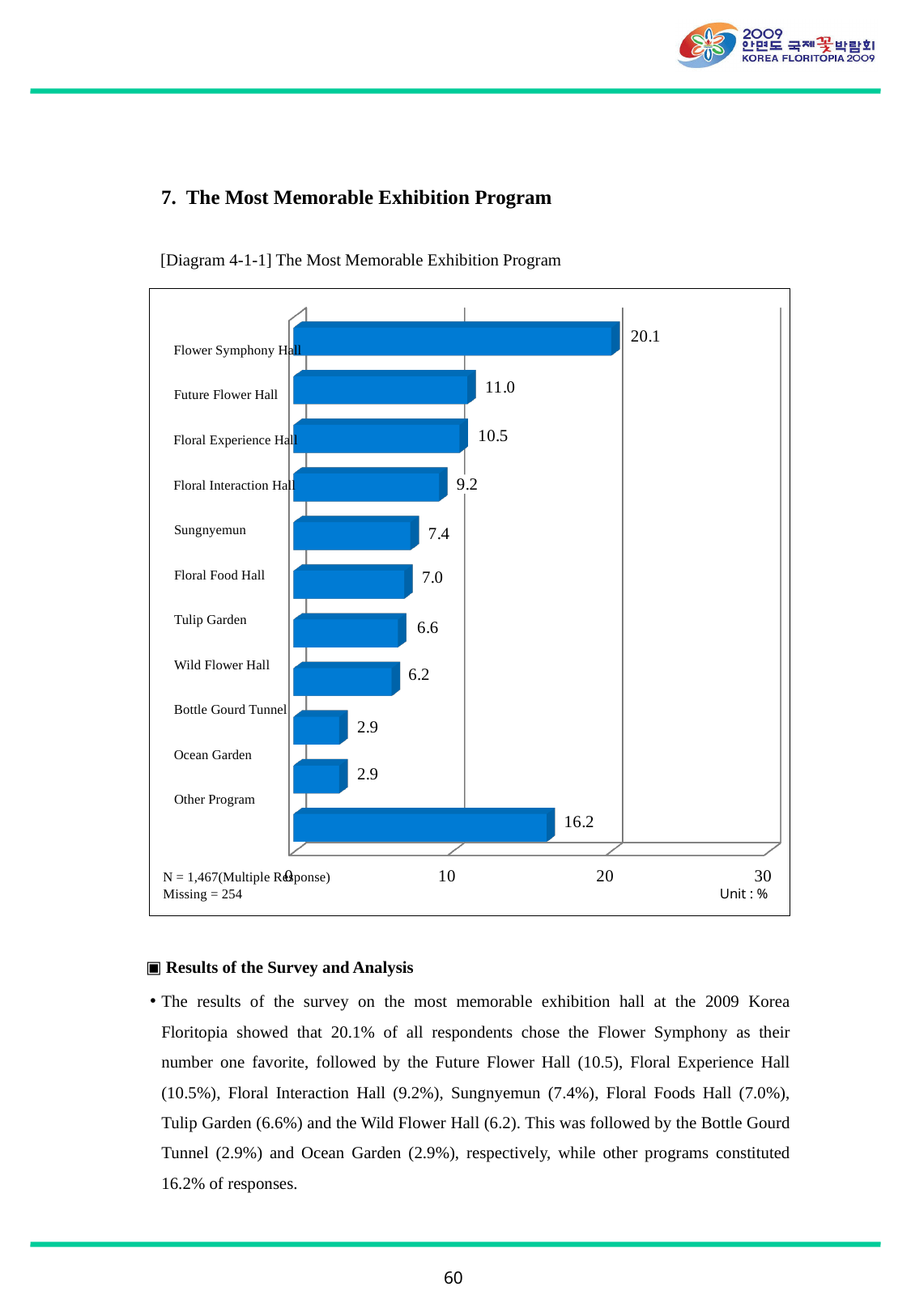
What is the difference between the values for Floral Experience Hall and Wild Flower Hall? 4.3 What is the value for Tulip Garden? 6.6 What kind of chart is shown in Diagram 4-1-1? bar chart What unit is indicated for the values in the chart? % Is the value for Other Program greater or less than 20? less Which category has the highest value? Flower Symphony Hall How many categories are plotted in the chart? 11 What is the value for Floral Interaction Hall? 9.2 Which is larger, the value for Sungnyemun or the value for Floral Food Hall? Sungnyemun What is the difference between the values for Flower Symphony Hall and Future Flower Hall? 9.1 What is the value for Other Program? 16.2 What is the value for Flower Symphony Hall? 20.1